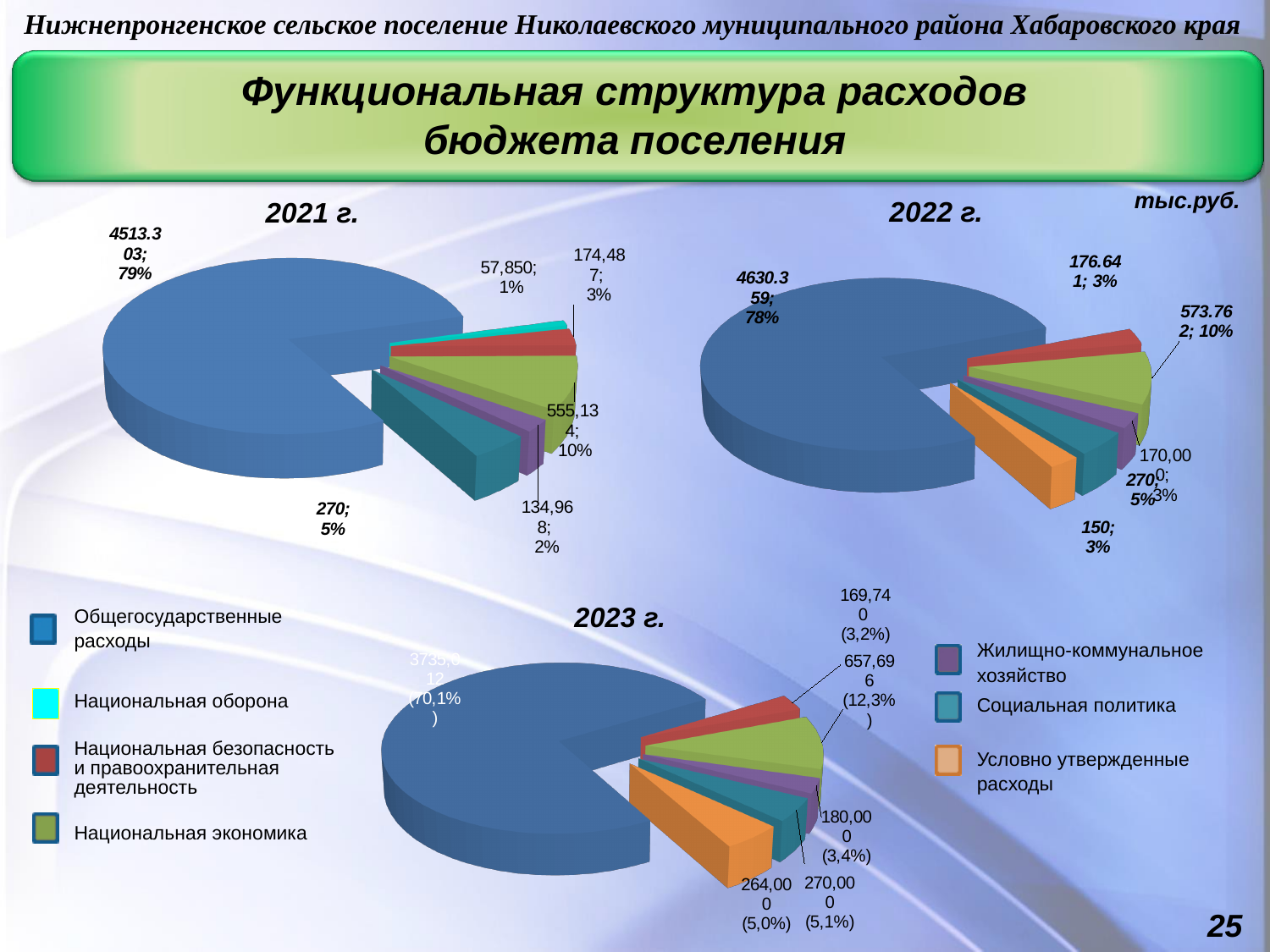
In the 2021 chart, what share is Национальная оборона? 1% How many categories does the legend on the slide list? 7 In the 2022 chart, what is the value for Общегосударственные расходы? 4630.359 In the 2023 chart, which category has the largest share? Общегосударственные расходы What type of charts are shown on the slide? Pie charts In the 2023 chart, what is the value for Социальная политика? 270,000 In the 2021 chart, which is larger: Национальная экономика or Социальная политика? Национальная экономика In the 2021 chart, what is the value for Национальная экономика? 555,134 In the 2023 chart, what share is Национальная экономика? 12,3% In the 2022 chart, what share is Национальная экономика? 10% In the 2022 chart, what is the value for Условно утвержденные расходы? 150